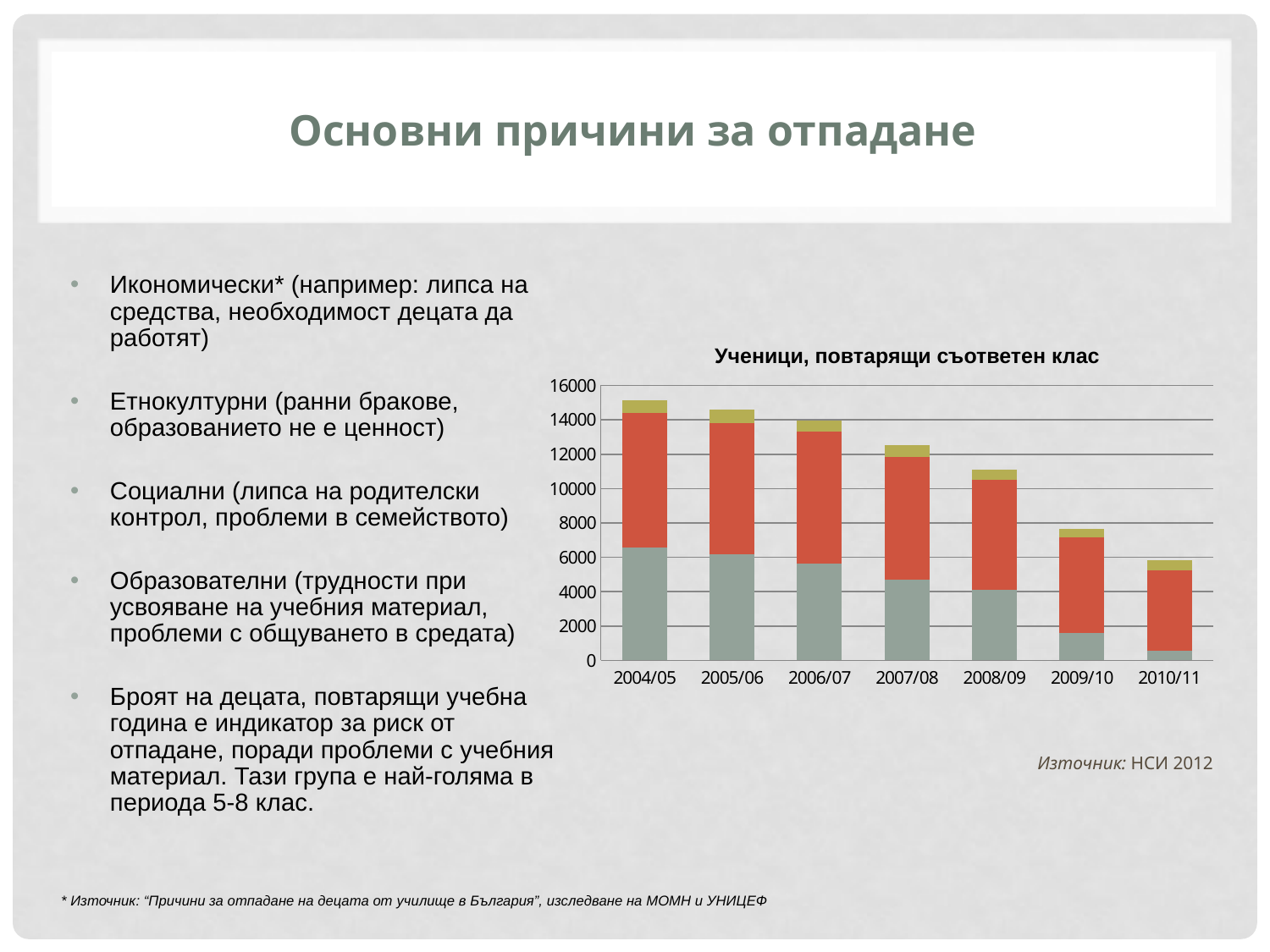
Which school year has the shortest stacked bar in the chart? 2010/11 Is the total bar height for 2004/05 greater or less than 14000? greater How many school years are shown on the x axis of the chart? 7 Is the total bar height for 2008/09 greater or less than 10000? greater Which has the taller stacked bar, 2005/06 or 2009/10? 2005/06 Is the total bar height for 2009/10 greater or less than 10000? less What is the title of the chart? Ученици, повтарящи съответен клас Do the total bar heights rise or fall from 2004/05 to 2010/11? fall What kind of chart is shown on the slide? stacked bar chart Which school year has the tallest stacked bar in the chart? 2004/05